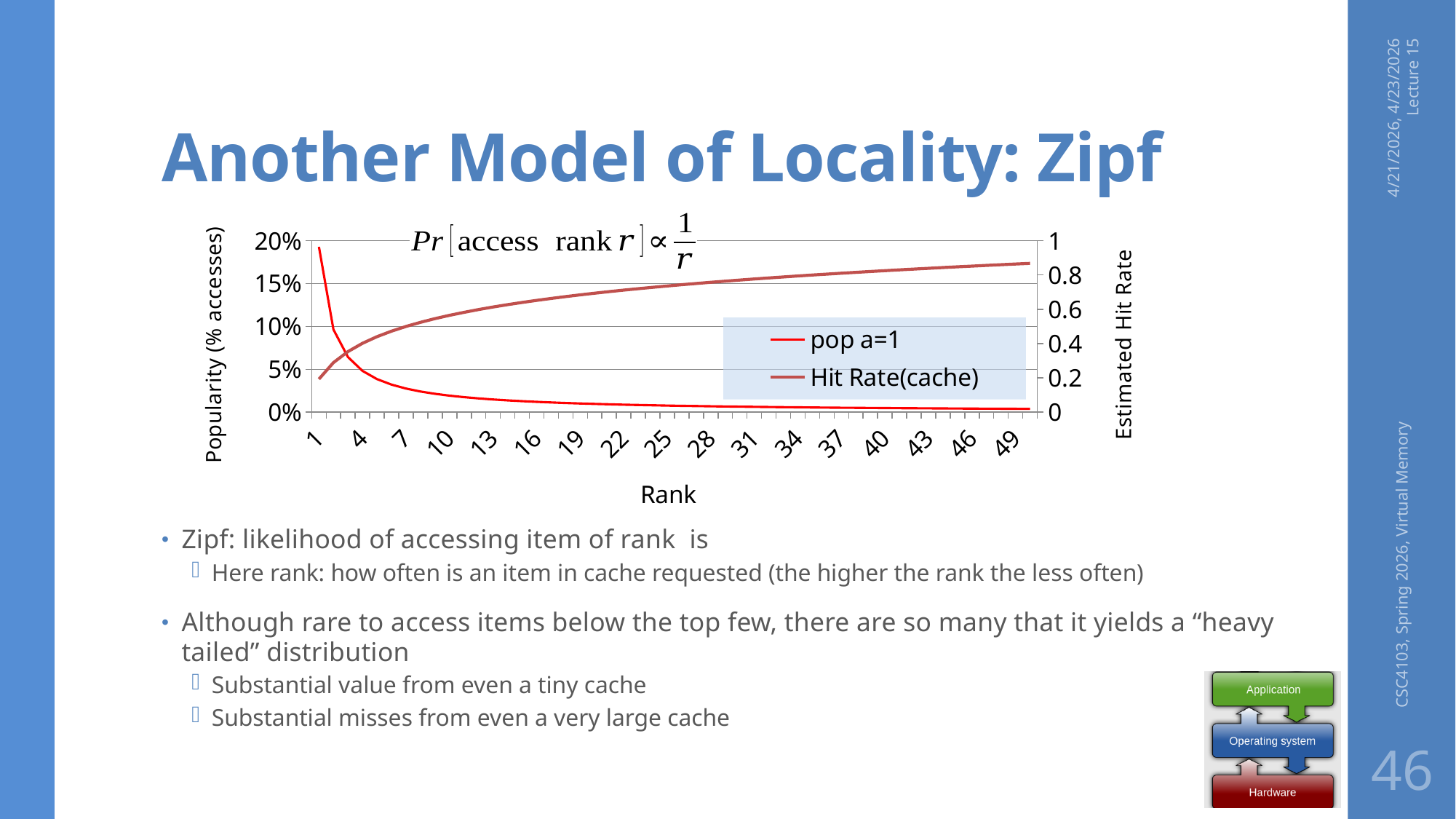
Which has the larger 'pop a=1' value, rank 1 or rank 49? rank 1 Does the 'pop a=1' series rise or fall as rank increases along the x axis? fall Is the 'pop a=1' value at rank 10 greater or less than 5%? less Is the 'pop a=1' value at rank 1 greater or less than 15%? greater How many series does the chart legend list? 2 What is the title of the x axis of the chart? Rank What are the two series named in the chart legend? pop a=1 and Hit Rate(cache) Does the 'Hit Rate(cache)' series rise or fall as rank increases along the x axis? rise What kind of chart is shown on the slide? line chart Is the 'Hit Rate(cache)' value at rank 49 greater or less than 0.8? greater At which rank is the 'pop a=1' series highest? 1